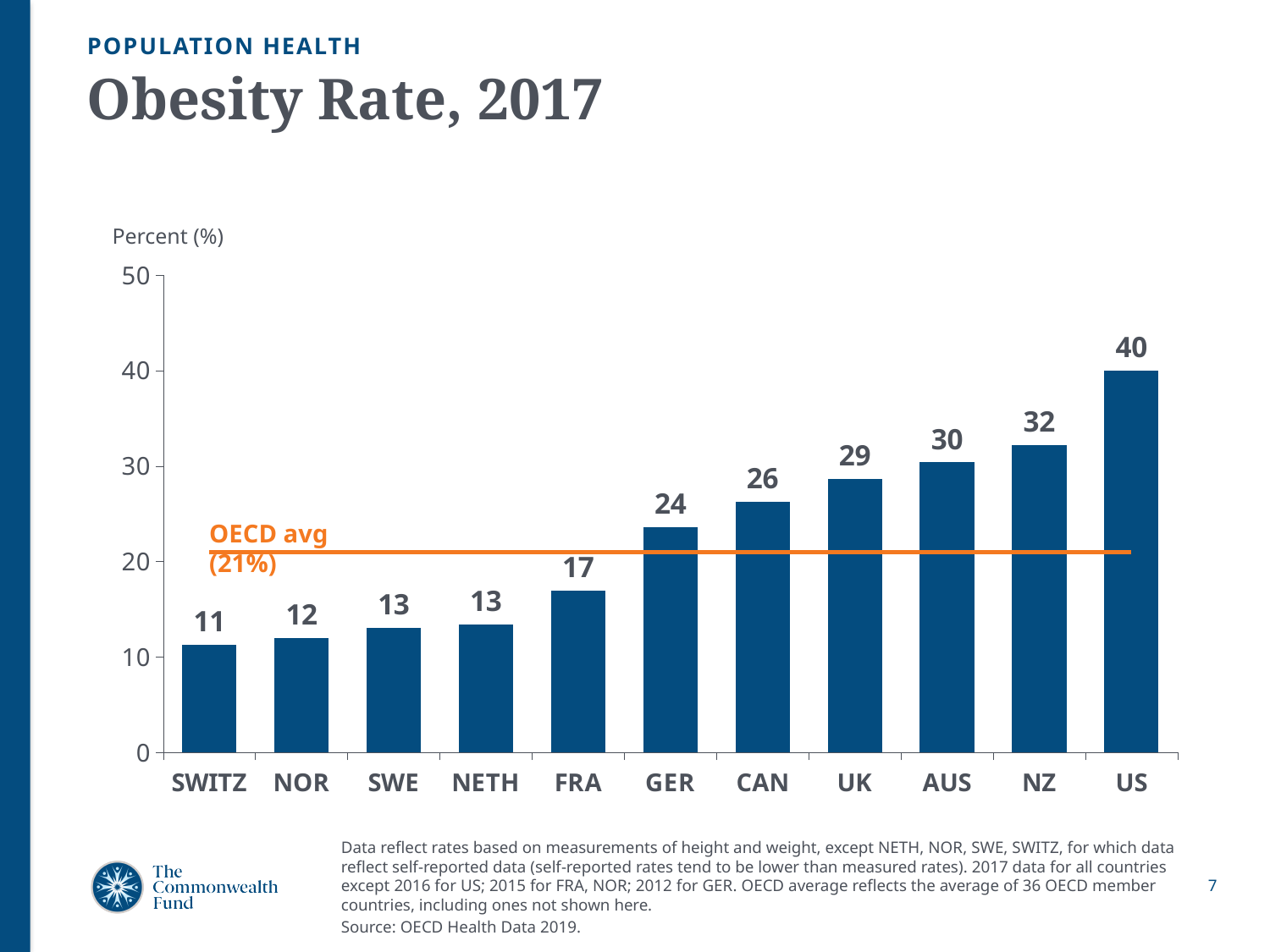
Do the values rise or fall from left to right along the x axis? Rise What kind of chart is shown on the slide? Bar chart Which country has the lowest obesity rate? SWITZ Is the value for NZ greater or less than 30? greater Which has a higher obesity rate, CAN or AUS? AUS What OECD average is marked by the orange line? 21% What is the obesity rate for the US? 40 What is the obesity rate for FRA? 17 Which country has the highest obesity rate? US How many countries are shown in the chart? 11 What is the obesity rate for GER? 24 What is the difference between the obesity rates of the US and SWITZ? 29